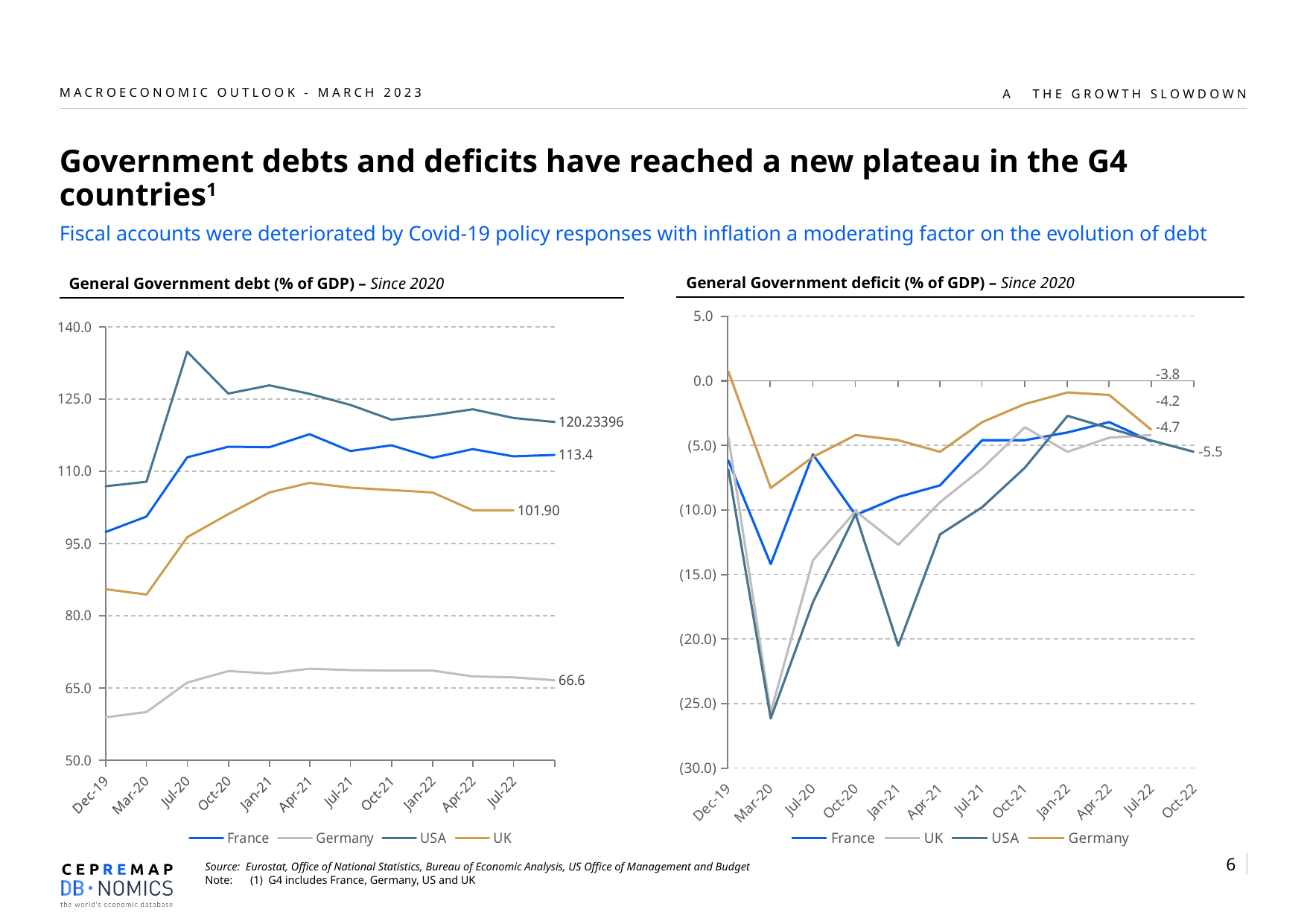
In the General Government deficit chart, is the value for the USA at Mar-20 greater or less than -25.0? less In the General Government debt chart, what is the final labelled value for France? 113.4 In the General Government debt chart, which country has the highest debt at the end of the series? USA In the General Government debt chart, what is the final labelled value for the USA? 120.23396 In the General Government debt chart, which country has the lowest debt at the end of the series? Germany In the General Government debt chart, is the value for the USA at Jul-20 greater or less than 125.0? greater How many series does the legend of the General Government debt chart list? 4 In the General Government debt chart, what is the final labelled value for Germany? 66.6 In the General Government deficit chart, what is the labelled value for the USA at Oct-22? -5.5 In the General Government deficit chart, does the Germany line rise or fall between Mar-20 and Jan-22? Rise What kind of chart is the General Government debt chart on the left? Line chart In the General Government debt chart, what is the difference between the final labelled values for France and Germany? 46.8